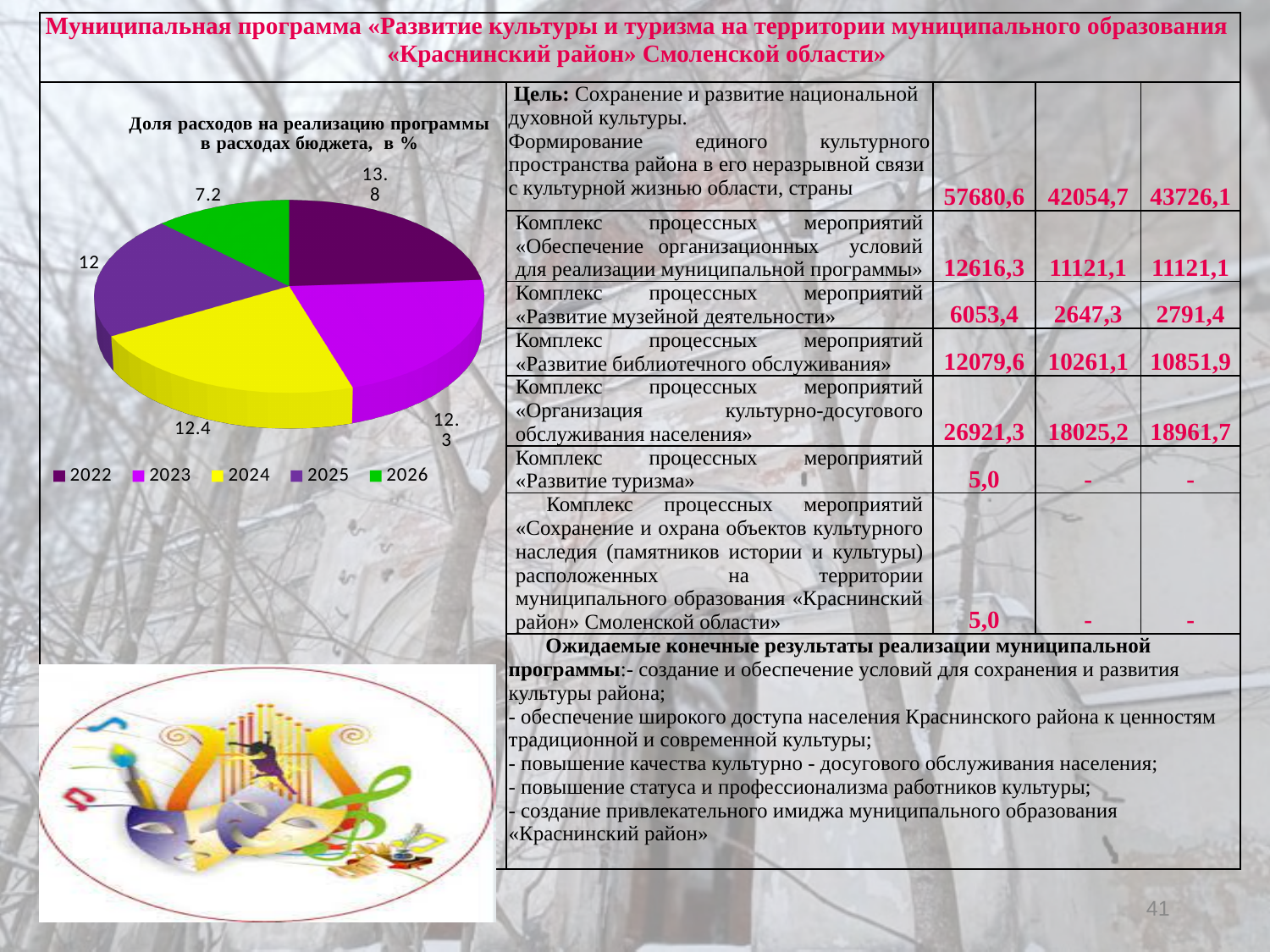
Which year has the smallest share in the pie chart? 2026 What type of chart is shown on the slide? pie chart What is the value for 2024 in the pie chart? 12.4 What is the difference between the values for 2022 and 2026 in the pie chart? 6.6 Which is larger in the pie chart, the value for 2025 or the value for 2026? 2025 What is the value for 2025 in the pie chart? 12 How many slices does the pie chart have? 5 What is the value for 2022 in the pie chart? 13.8 Which year has the largest share in the pie chart? 2022 How many entries does the legend of the pie chart list? 5 What colour is the 2024 slice in the pie chart? yellow What is the value for 2026 in the pie chart? 7.2